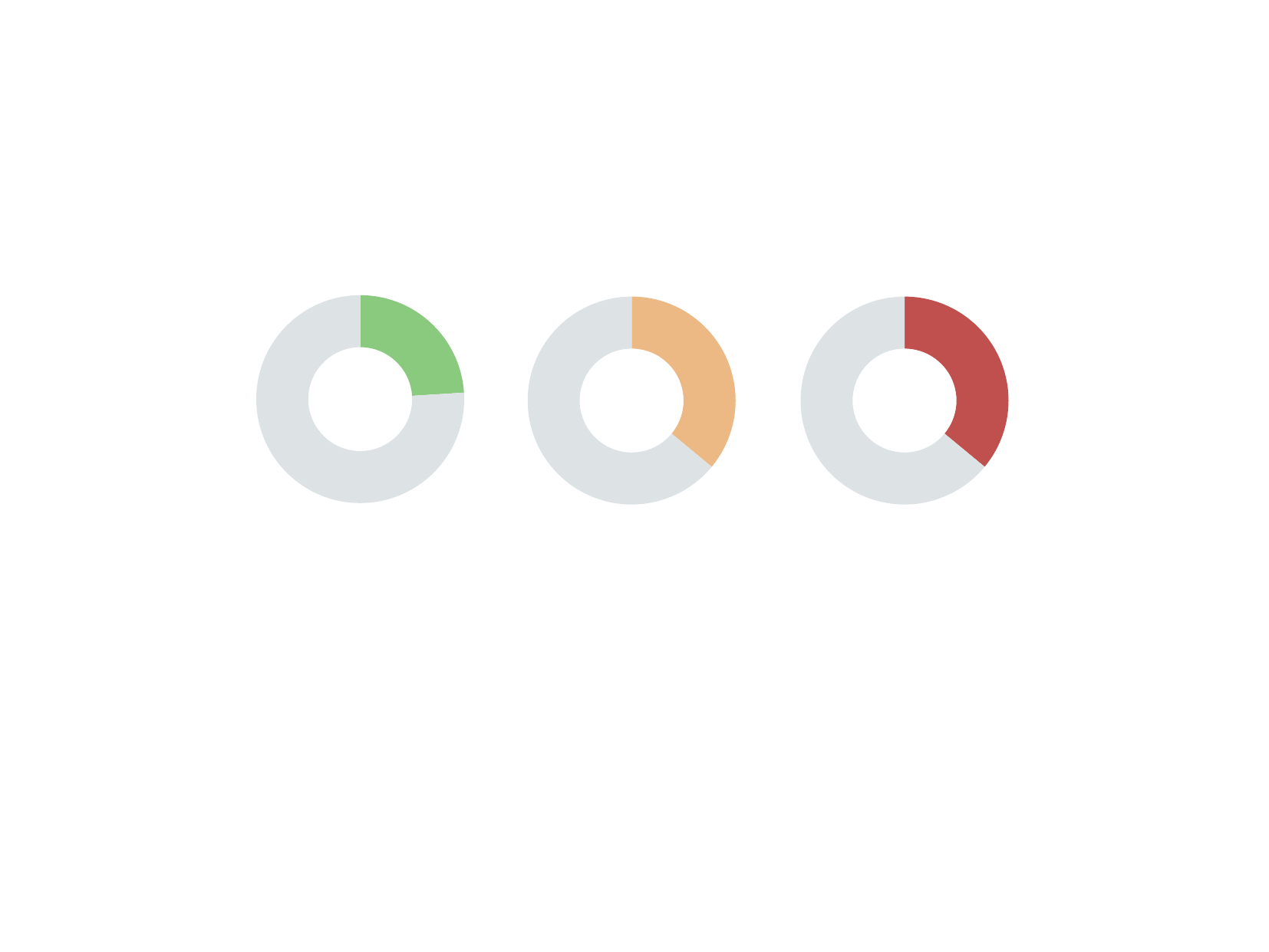
What colour is the highlighted slice in the middle doughnut chart? Orange Which is larger: the green slice in the left chart or the orange slice in the middle chart? The orange slice What colour is the highlighted slice in the right doughnut chart? Red Does the slide show a legend for the doughnut charts? No Which of the three doughnut charts has the smallest coloured slice? The left (green) chart How many doughnut charts are shown on the slide? 3 What kind of chart is shown on the left of the slide? Doughnut (pie) chart Which is larger: the green slice in the left chart or the red slice in the right chart? The red slice How many slices does the left doughnut chart have? 2